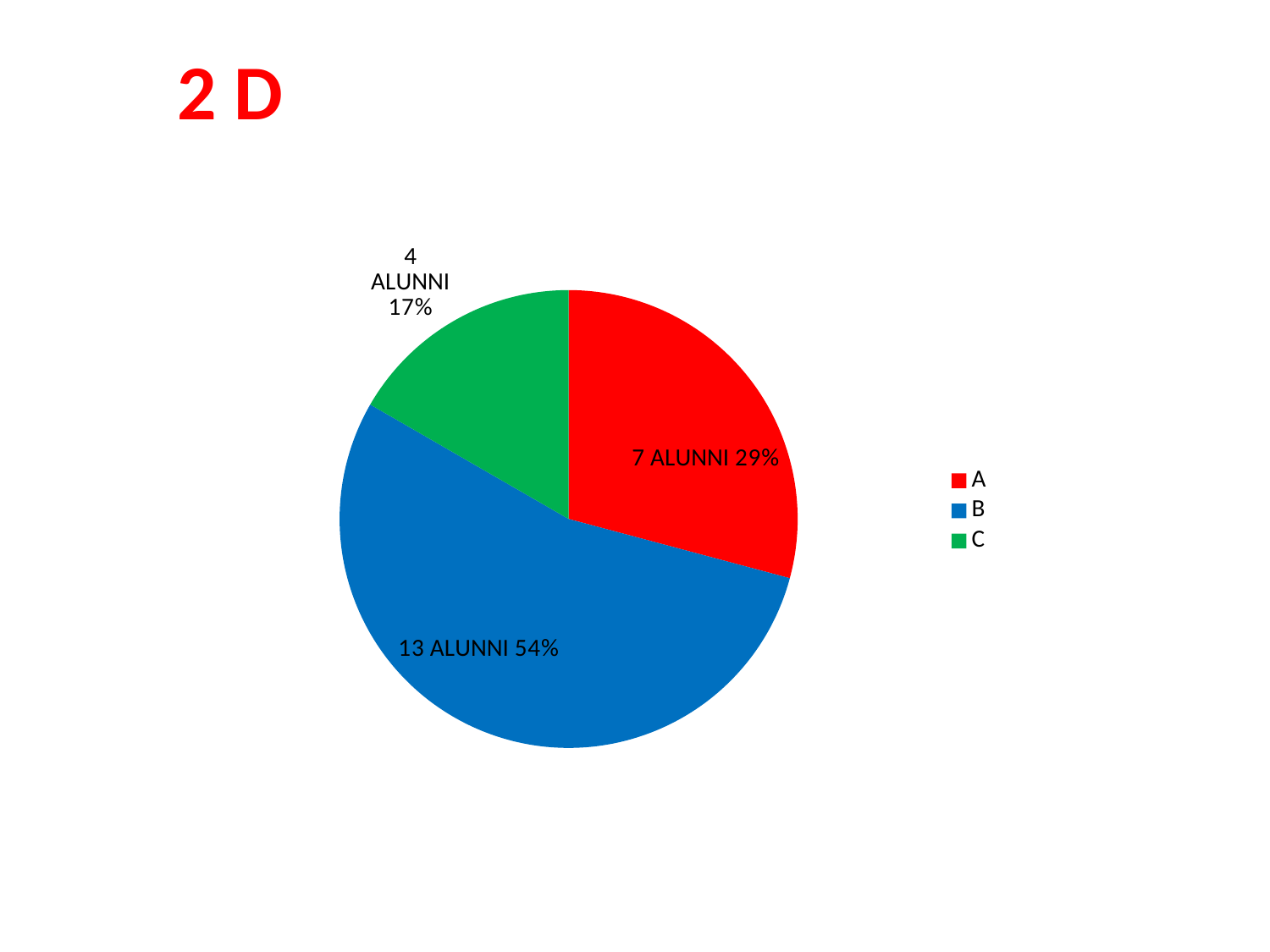
How many slices does the pie chart have? 3 What colour is the slice for category B? blue How many alunni are in category B? 13 ALUNNI What percentage share does slice A have? 29% How many entries does the legend list? 3 How many alunni are in category C? 4 ALUNNI Which category has the smallest slice? C What percentage share does slice B have? 54% Which is larger, the slice for A or the slice for C? A What percentage share does slice C have? 17% What kind of chart is shown on the slide? pie chart Which category has the largest slice? B